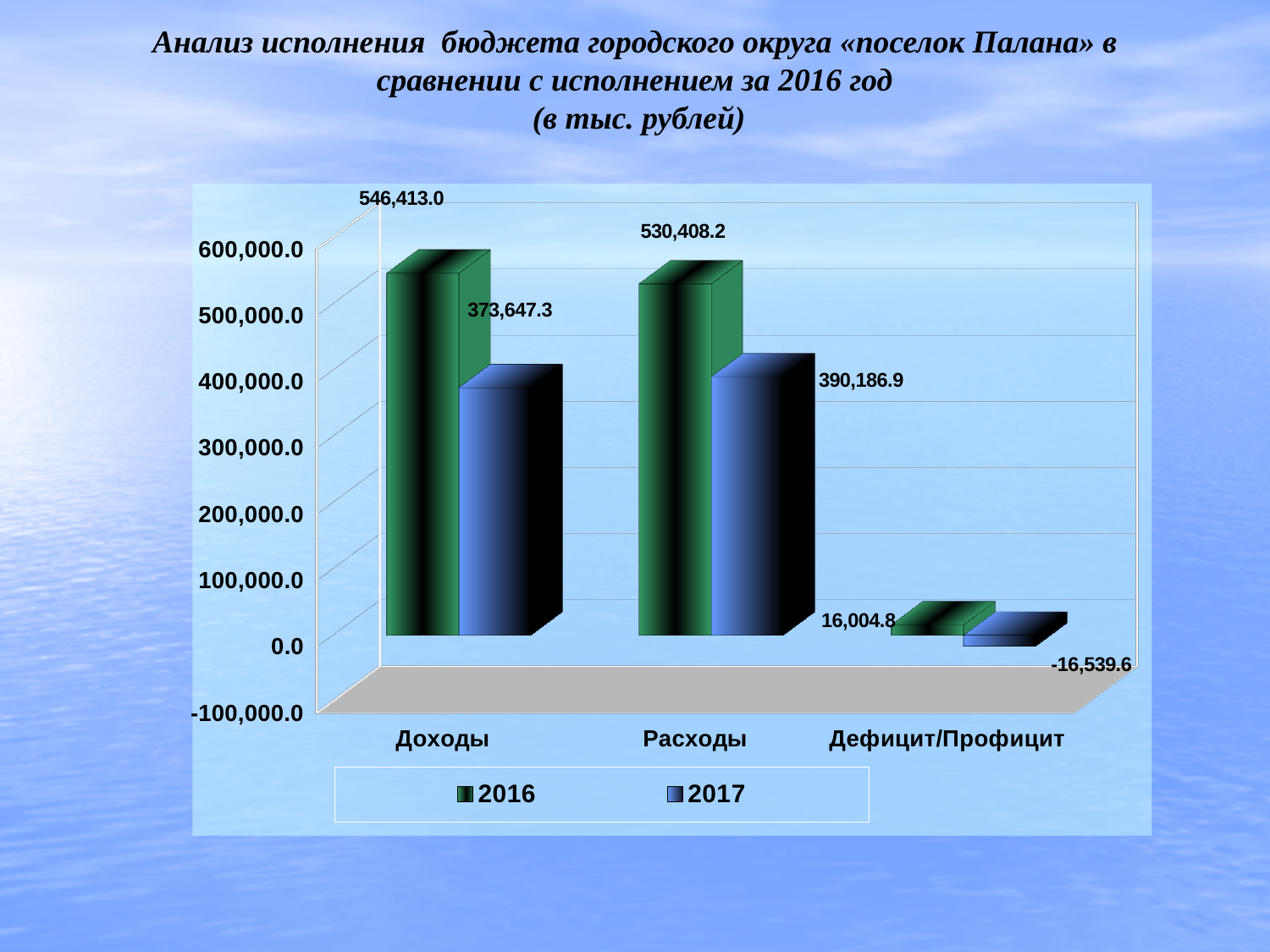
What kind of chart is shown on the slide? Bar chart Which category has the lowest value in the 2017 series? Дефицит/Профицит Which category has the highest value in the 2016 series? Доходы What is the difference between the 2016 and 2017 values for Доходы? 172,765.7 What is the value for Расходы in the 2017 series? 390,186.9 What is the value for Доходы in the 2016 series? 546,413.0 What is the value for Дефицит/Профицит in the 2017 series? -16,539.6 How many series does the legend list? 2 How many categories are shown on the x axis? 3 Which is larger for Расходы: the 2016 value or the 2017 value? 2016 What is the value for Доходы in the 2017 series? 373,647.3 What is the value for Расходы in the 2016 series? 530,408.2